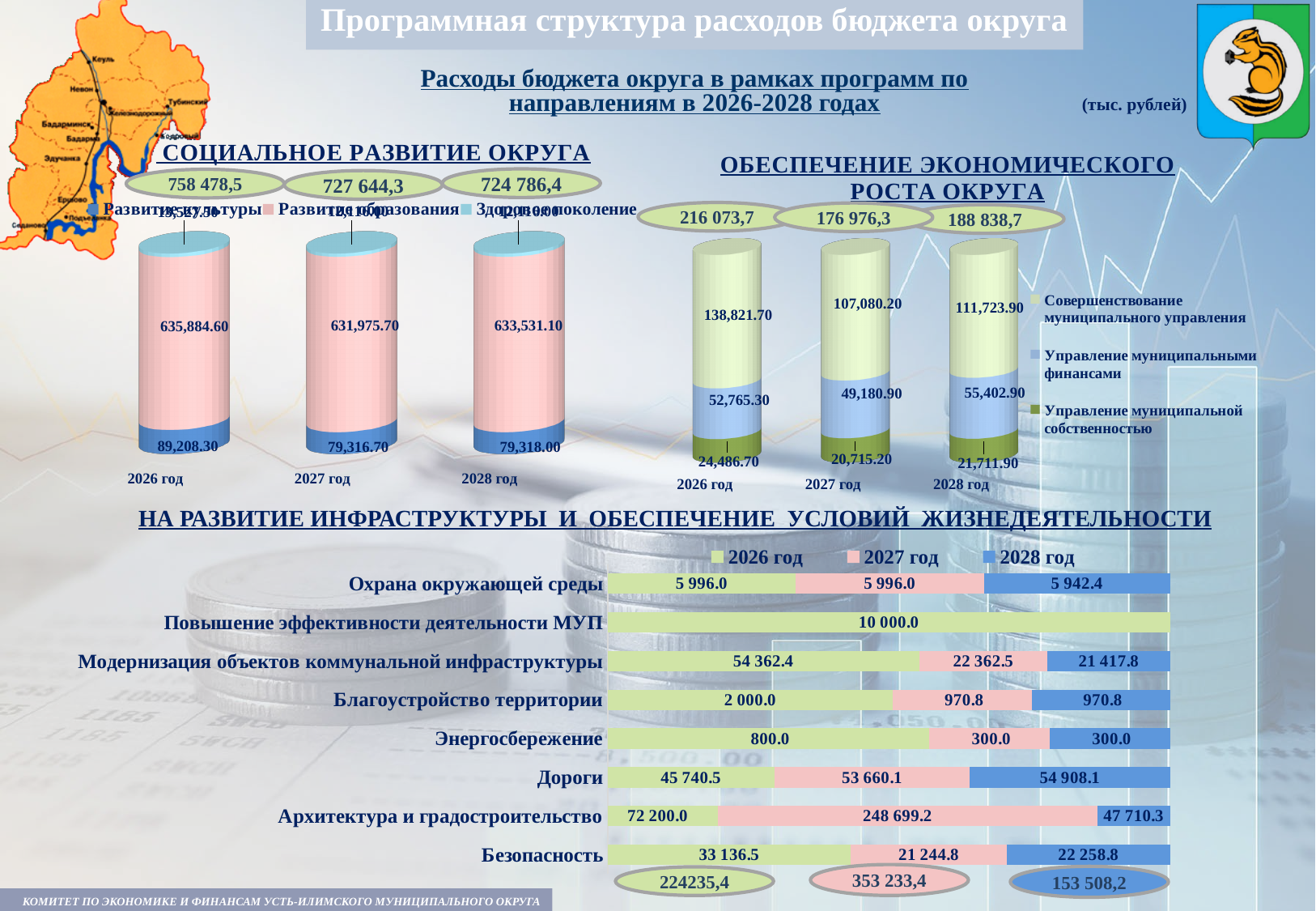
On the 'СОЦИАЛЬНОЕ РАЗВИТИЕ ОКРУГА' chart, what is the value for Развитие образования in 2026 год? 635,884.60 On the 'ОБЕСПЕЧЕНИЕ ЭКОНОМИЧЕСКОГО РОСТА ОКРУГА' chart, which year has the lowest value for Совершенствование муниципального управления? 2027 год On the 'НА РАЗВИТИЕ ИНФРАСТРУКТУРЫ И ОБЕСПЕЧЕНИЕ УСЛОВИЙ ЖИЗНЕДЕЯТЕЛЬНОСТИ' chart, how many categories are shown? 8 On the 'ОБЕСПЕЧЕНИЕ ЭКОНОМИЧЕСКОГО РОСТА ОКРУГА' chart, what is the value for Управление муниципальными финансами in 2028 год? 55,402.90 On the 'НА РАЗВИТИЕ ИНФРАСТРУКТУРЫ И ОБЕСПЕЧЕНИЕ УСЛОВИЙ ЖИЗНЕДЕЯТЕЛЬНОСТИ' chart, which category has the highest value for 2027 год? Архитектура и градостроительство On the 'ОБЕСПЕЧЕНИЕ ЭКОНОМИЧЕСКОГО РОСТА ОКРУГА' chart, what is the difference between the Управление муниципальной собственностью values for 2026 год and 2027 год? 3,771.50 On the 'НА РАЗВИТИЕ ИНФРАСТРУКТУРЫ И ОБЕСПЕЧЕНИЕ УСЛОВИЙ ЖИЗНЕДЕЯТЕЛЬНОСТИ' chart, which is larger for Модернизация объектов коммунальной инфраструктуры: 2026 год or 2027 год? 2026 год What kind of chart is the 'НА РАЗВИТИЕ ИНФРАСТРУКТУРЫ И ОБЕСПЕЧЕНИЕ УСЛОВИЙ ЖИЗНЕДЕЯТЕЛЬНОСТИ' chart? Stacked horizontal bar chart On the 'СОЦИАЛЬНОЕ РАЗВИТИЕ ОКРУГА' chart, what is the value for Развитие культуры in 2027 год? 79,316.70 On the 'ОБЕСПЕЧЕНИЕ ЭКОНОМИЧЕСКОГО РОСТА ОКРУГА' chart, what is the total shown for 2026 год? 216 073,7 On the 'СОЦИАЛЬНОЕ РАЗВИТИЕ ОКРУГА' chart, how many series does the legend list? 3 On the 'НА РАЗВИТИЕ ИНФРАСТРУКТУРЫ И ОБЕСПЕЧЕНИЕ УСЛОВИЙ ЖИЗНЕДЕЯТЕЛЬНОСТИ' chart, what is the value for Дороги in 2028 год? 54 908.1